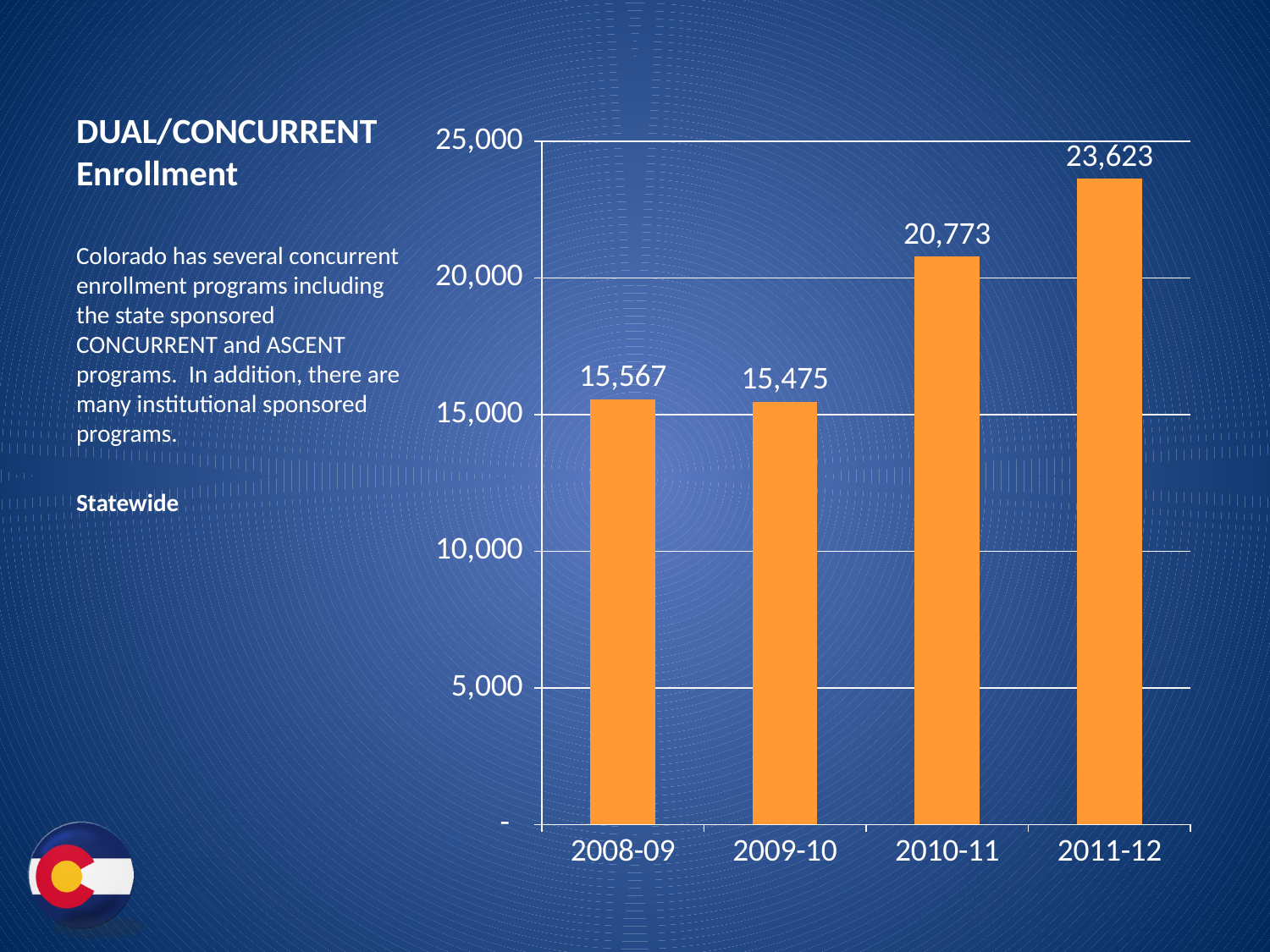
What kind of chart is shown on the slide? bar chart What is the value for 2009-10? 15,475 What is the difference between the values for 2011-12 and 2010-11? 2,850 Which is larger, the value for 2010-11 or the value for 2009-10? 2010-11 How many years are shown on the x axis? 4 What is the value for 2010-11? 20,773 Is the value for 2010-11 greater or less than 20,000? greater Which year has the lowest value? 2009-10 What is the value for 2011-12? 23,623 Which year has the highest value? 2011-12 What is the value for 2008-09? 15,567 What is the difference between the values for 2008-09 and 2009-10? 92